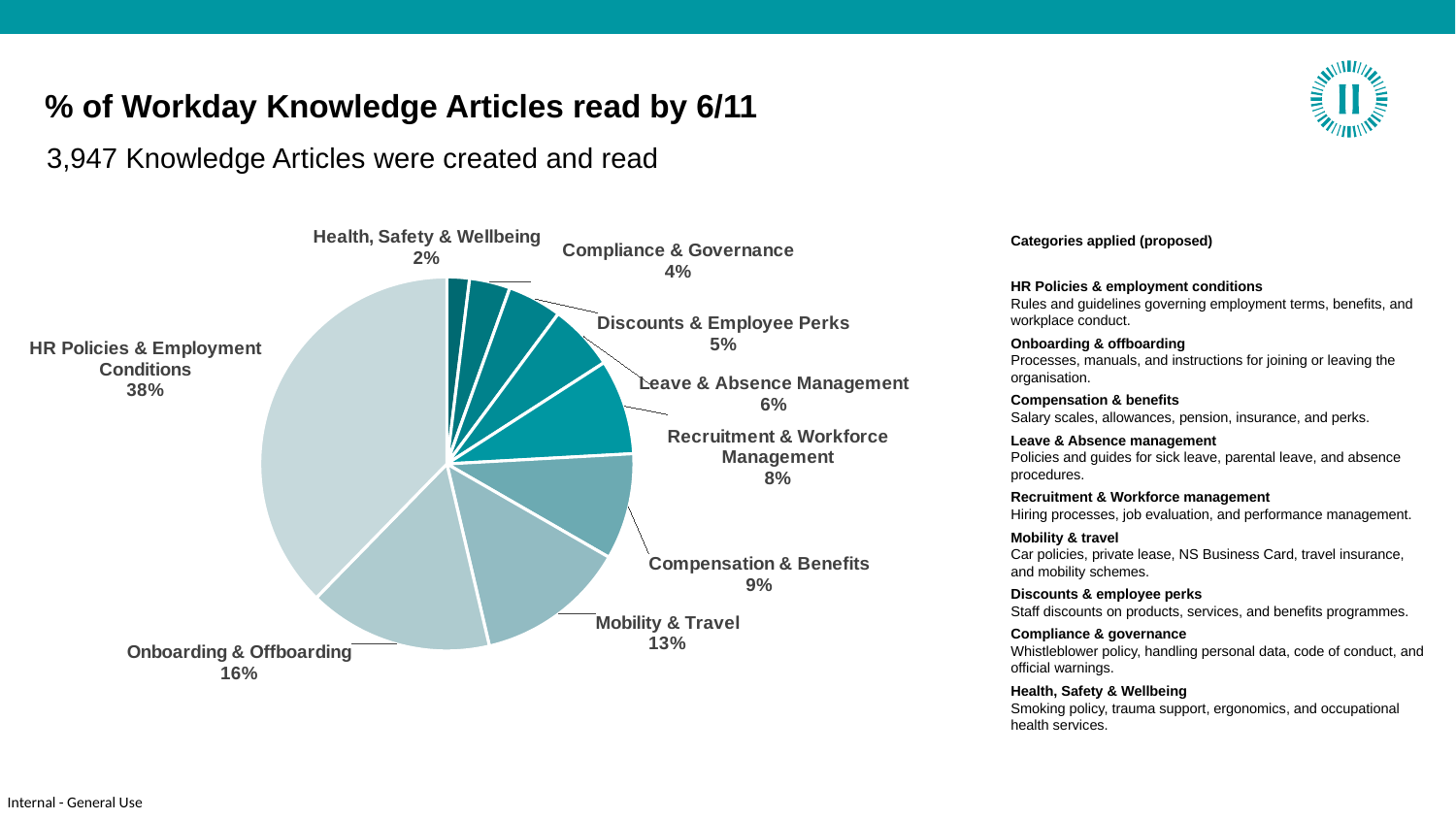
What kind of chart is shown on the slide? Pie chart What is the title of the chart on the slide? % of Workday Knowledge Articles read by 6/11 What share of the pie does Onboarding & Offboarding represent? 16% What is the difference in percentage points between HR Policies & Employment Conditions and Onboarding & Offboarding? 22 What percentage of Workday Knowledge Articles read were in the HR Policies & Employment Conditions category? 38% How many categories are shown in the pie chart? 9 What is the value shown for Mobility & Travel? 13% Which category has the largest slice of the pie chart? HR Policies & Employment Conditions Which category has the smallest slice of the pie chart? Health, Safety & Wellbeing What is the difference in percentage points between Onboarding & Offboarding and Mobility & Travel? 3 Which is larger: Compensation & Benefits or Recruitment & Workforce Management? Compensation & Benefits What percentage is shown for Leave & Absence Management? 6%